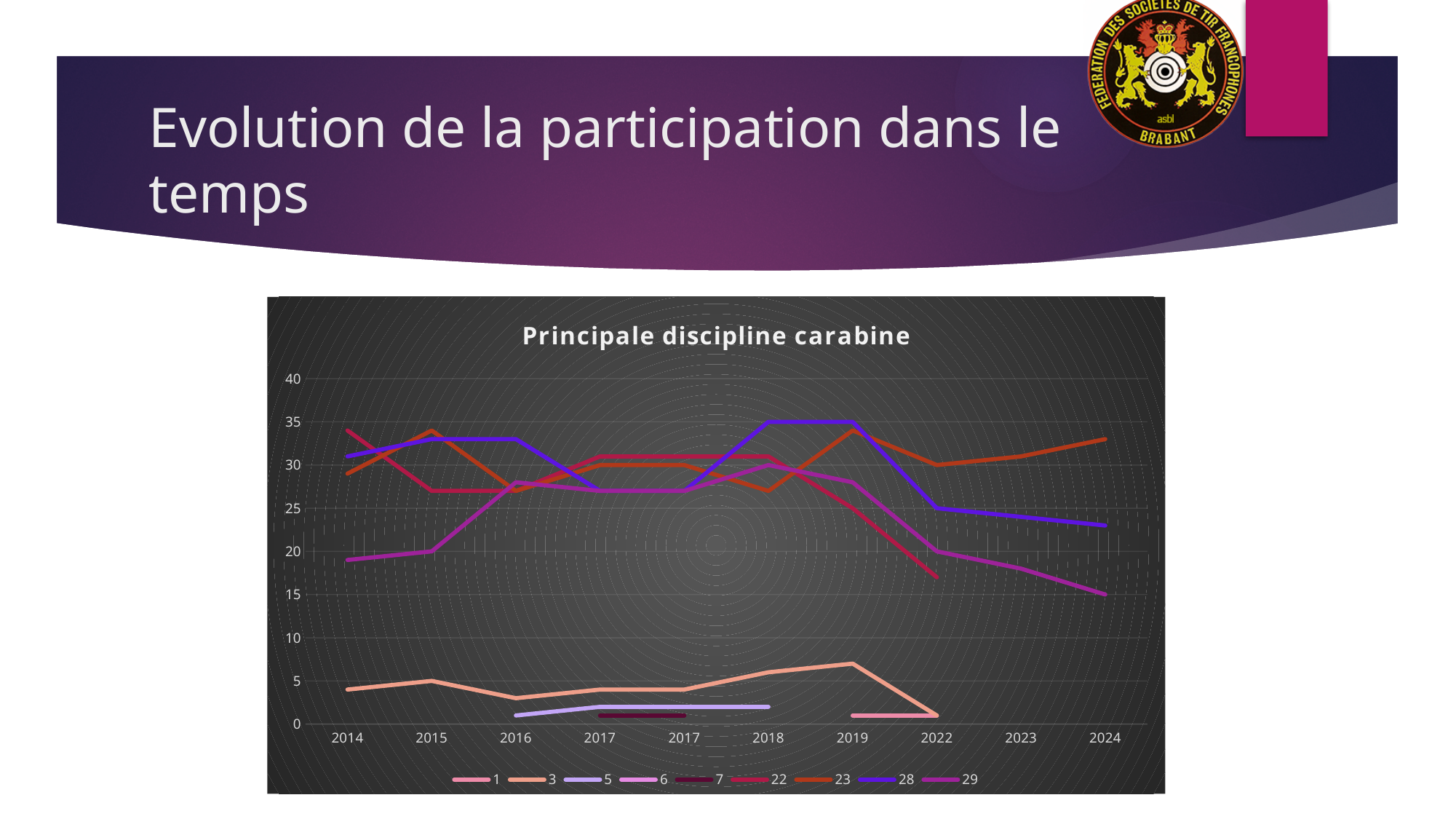
What kind of chart is shown on the slide? line chart How many series does the legend list? 9 Is the value for series 28 in 2024 greater or less than 25? less Does the value for series 29 rise or fall from 2019 to 2024? fall Is the value for series 3 in 2019 greater or less than 5? greater In 2024, which is larger: the value for series 23 or the value for series 28? series 23 How many points are labelled along the x axis? 10 Is the value for series 23 in 2024 greater or less than 30? greater What is the title of the chart? Principale discipline carabine Does the value for series 23 rise or fall from 2022 to 2024? rise